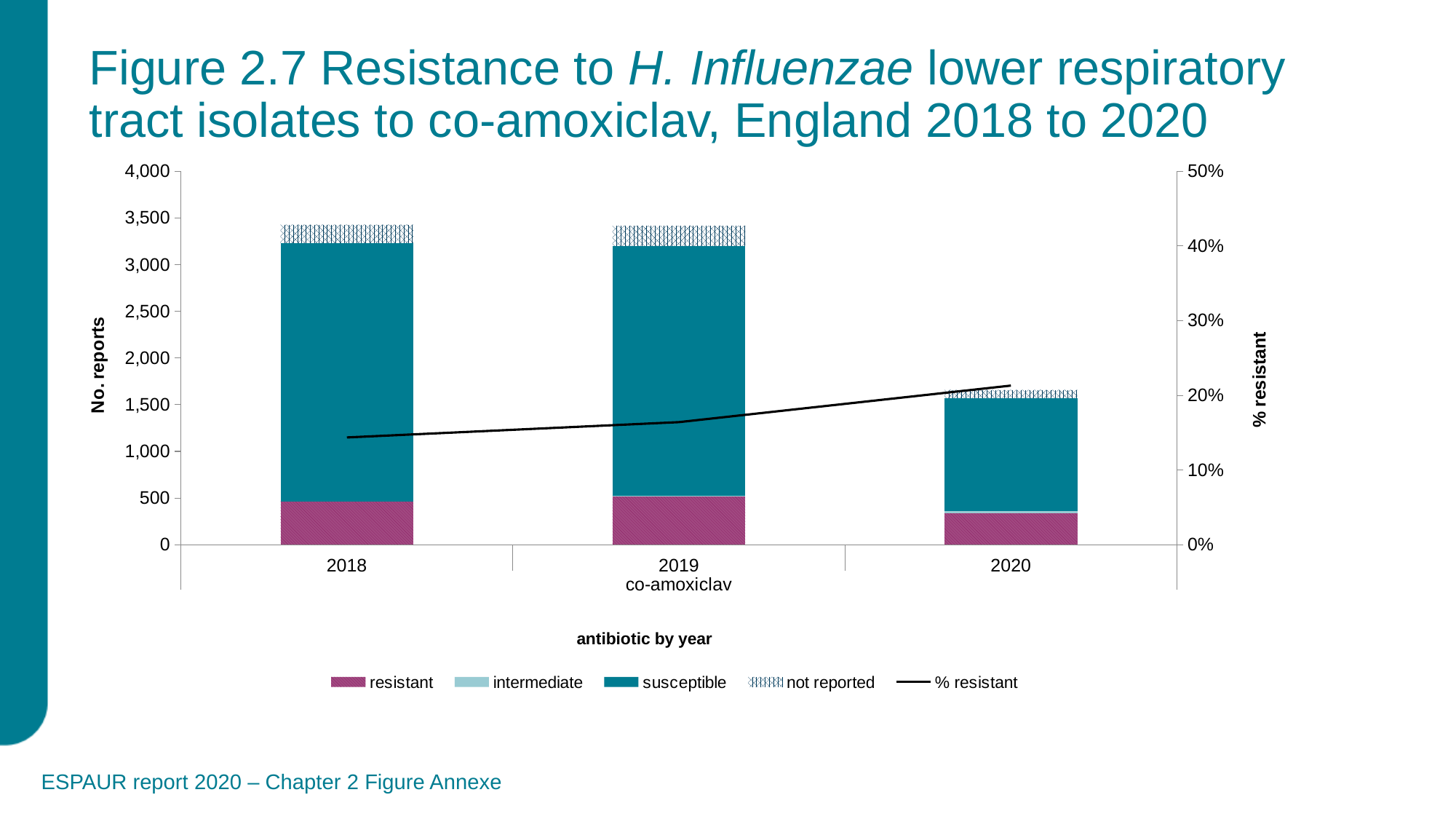
How many years are shown on the x axis of the chart? 3 Is the % resistant value for 2018 greater or less than 20%? less How many entries does the chart's legend list? 5 Is the total number of reports for 2020 greater or less than 2,000? less What is the label of the right vertical axis? % resistant Does the % resistant line rise or fall from 2018 to 2020? Rises Is the % resistant value for 2018 greater or less than 10%? greater What kind of chart is shown on the slide? A stacked bar chart with a line Which year has the lowest total number of reports? 2020 Which year has more total reports, 2018 or 2020? 2018 What is the label of the left vertical axis? No. reports